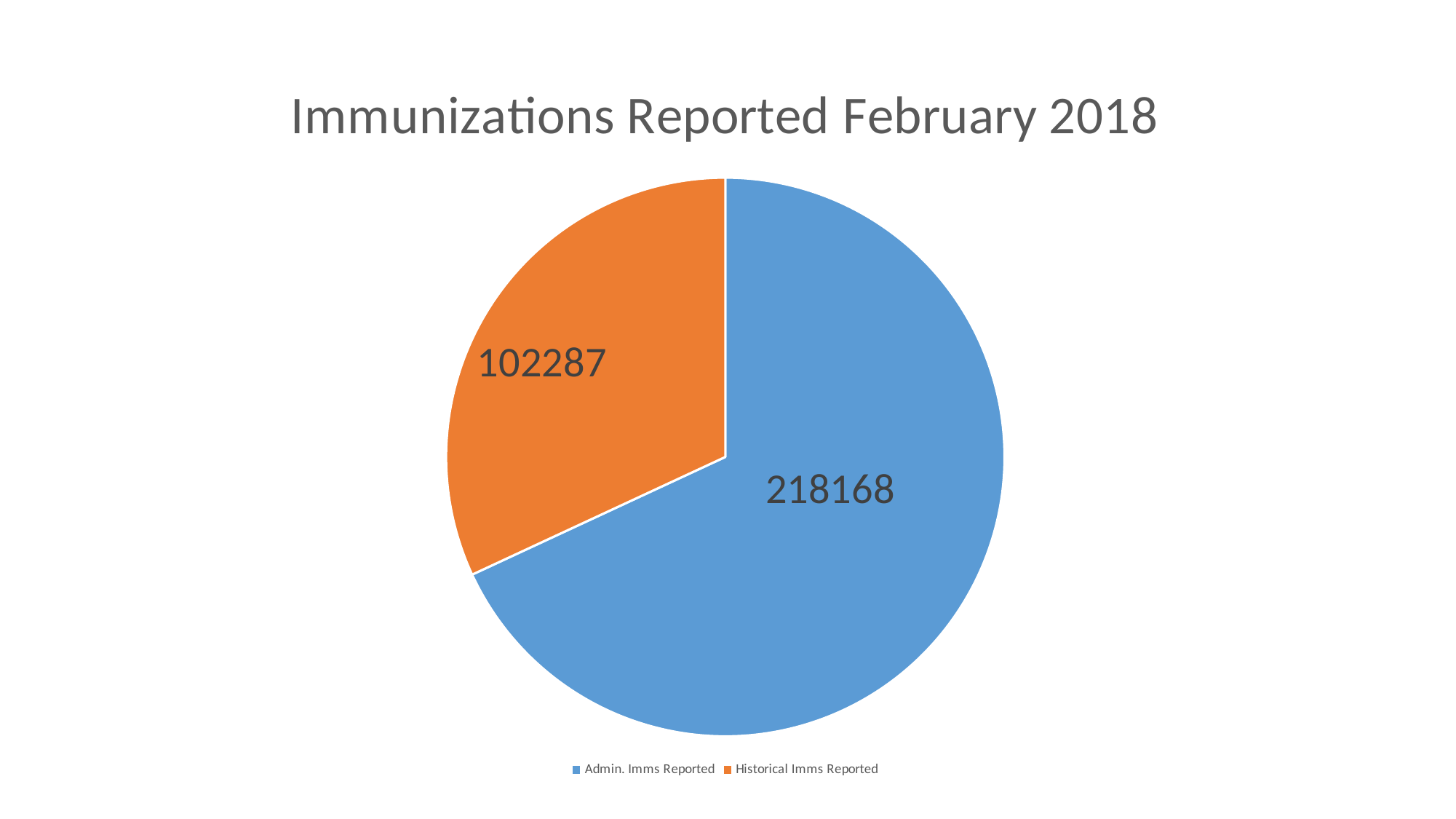
Which is larger, Admin. Imms Reported or Historical Imms Reported? Admin. Imms Reported Which category has the largest slice of the pie? Admin. Imms Reported What kind of chart is shown on the slide? Pie chart What is the total of the two slices in the pie chart? 320455 What is the difference between Admin. Imms Reported and Historical Imms Reported? 115881 What is the title of the chart? Immunizations Reported February 2018 Which category has the smallest slice of the pie? Historical Imms Reported What is the value for Admin. Imms Reported? 218168 What is the value for Historical Imms Reported? 102287 How many slices does the pie chart have? 2 How many entries does the legend list? 2